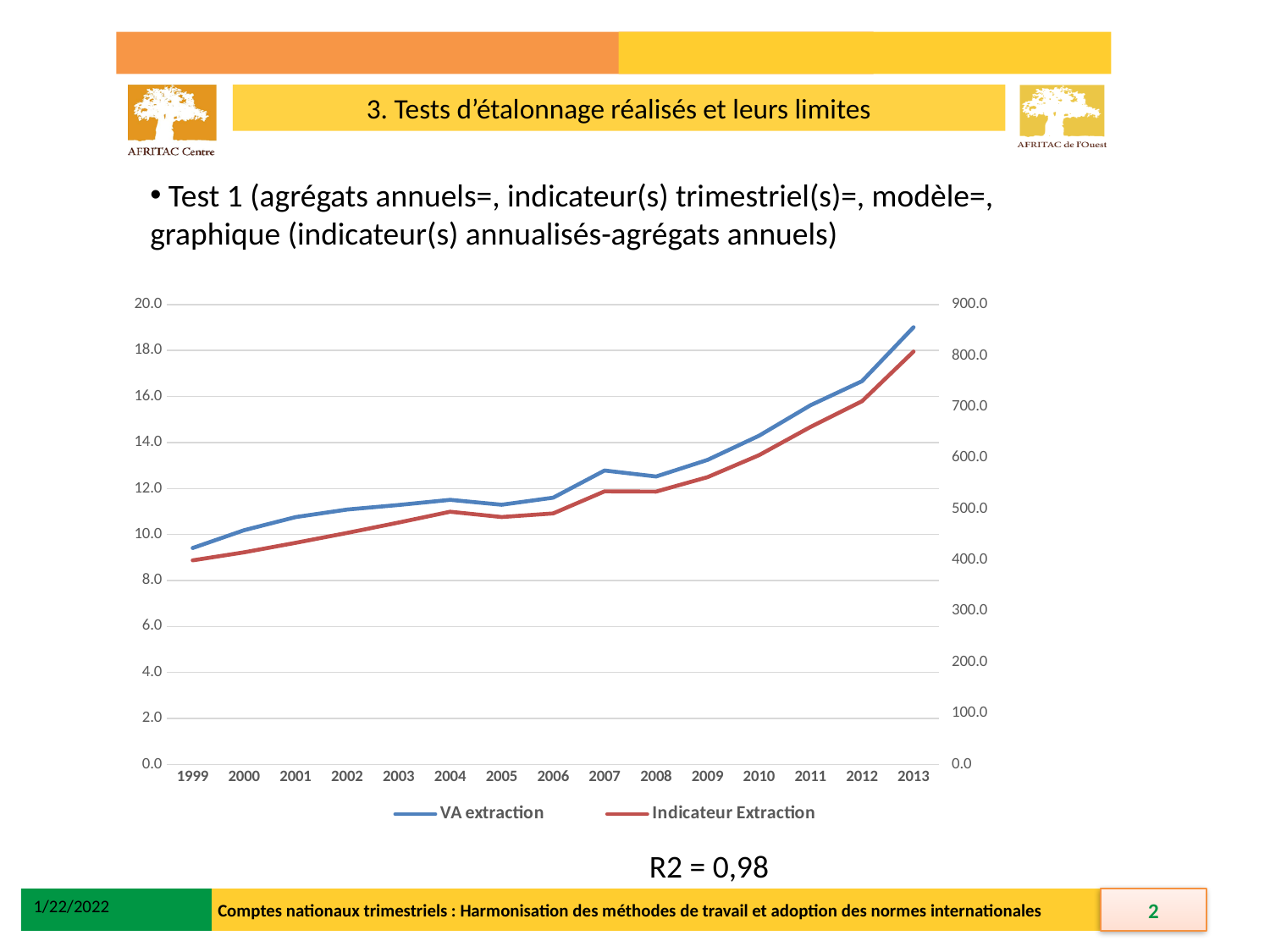
Is the VA extraction value for 2007 greater or less than 12.0 on the left axis? greater Which series is drawn in red in the chart? Indicateur Extraction Do the values of the VA extraction series generally rise or fall from 1999 to 2013? rise Which series is drawn in blue in the chart? VA extraction How many series does the chart legend list? 2 How many years are plotted along the x axis of the chart? 15 What kind of chart is shown on the slide? line chart In which year is the VA extraction series at its highest? 2013 Is the Indicateur Extraction value for 2013 greater or less than 700.0 on the right axis? greater Is the VA extraction value for 2013 greater or less than 18.0 on the left axis? greater In which year is the VA extraction series at its lowest? 1999